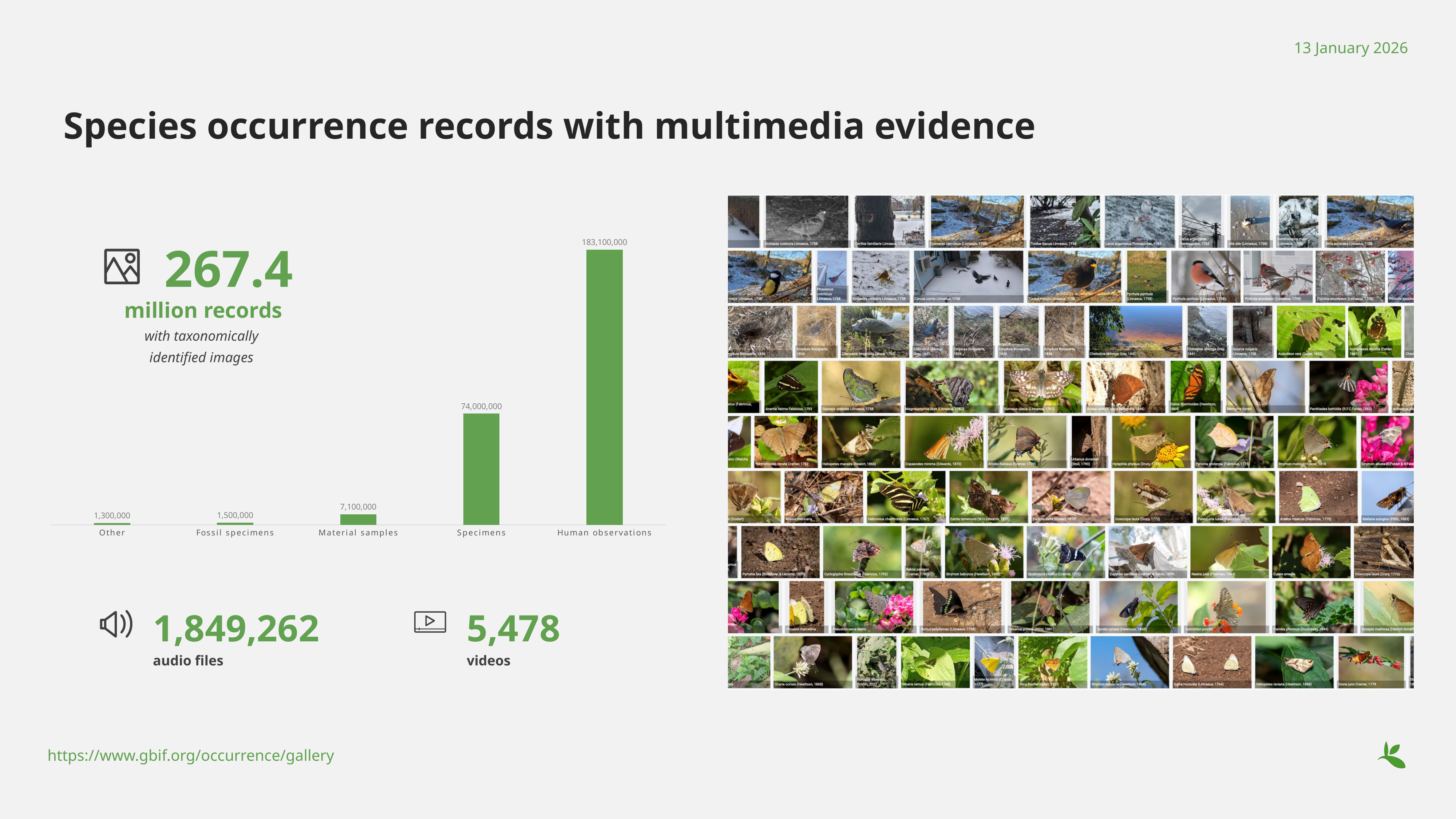
Which category has the lowest value? Other What kind of chart is shown on the slide? Bar chart Which category has the highest value? Human observations Which is larger, the value for Material samples or the value for Fossil specimens? Material samples What is the value for Specimens? 74,000,000 What is the value for Fossil specimens? 1,500,000 What is the difference between the values for Human observations and Specimens? 109,100,000 How many categories are shown in the bar chart? 5 What is the difference between the values for Fossil specimens and Other? 200,000 What is the value for Human observations? 183,100,000 What is the value for Other? 1,300,000 What is the value for Material samples? 7,100,000